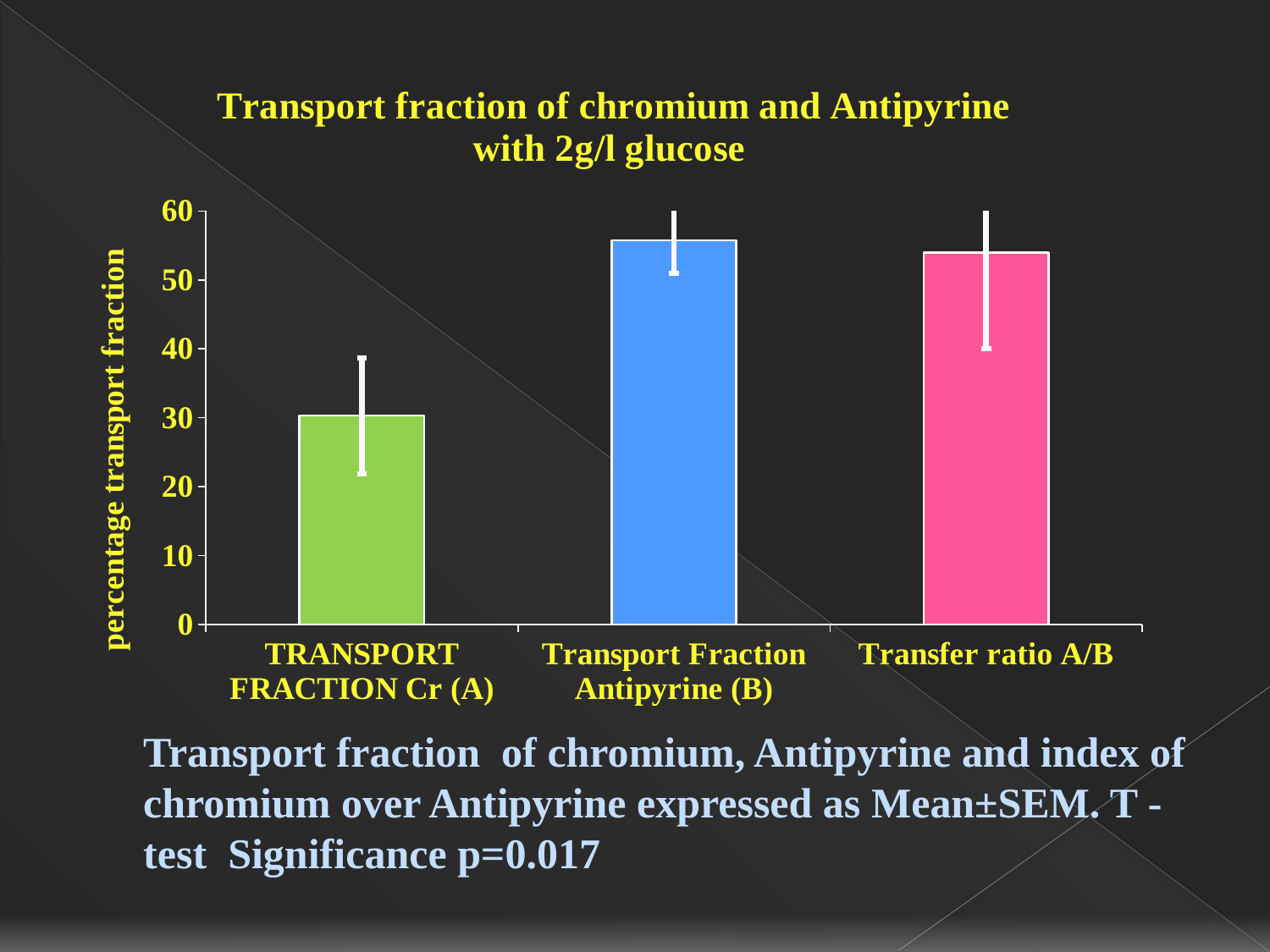
What is the label of the vertical axis of the chart? percentage transport fraction How many categories are plotted in the chart? 3 Is the value for TRANSPORT FRACTION Cr (A) greater or less than 20? greater Is the value for Transport Fraction Antipyrine (B) greater or less than 60? less Is the value for Transport Fraction Antipyrine (B) greater or less than 50? greater What kind of chart is shown on the slide? bar chart Which is larger, the value for TRANSPORT FRACTION Cr (A) or the value for Transport Fraction Antipyrine (B)? Transport Fraction Antipyrine (B) What is the title of the chart? Transport fraction of chromium and Antipyrine with 2g/l glucose Which category has the lowest value in the chart? TRANSPORT FRACTION Cr (A) Which category has the highest value in the chart? Transport Fraction Antipyrine (B)